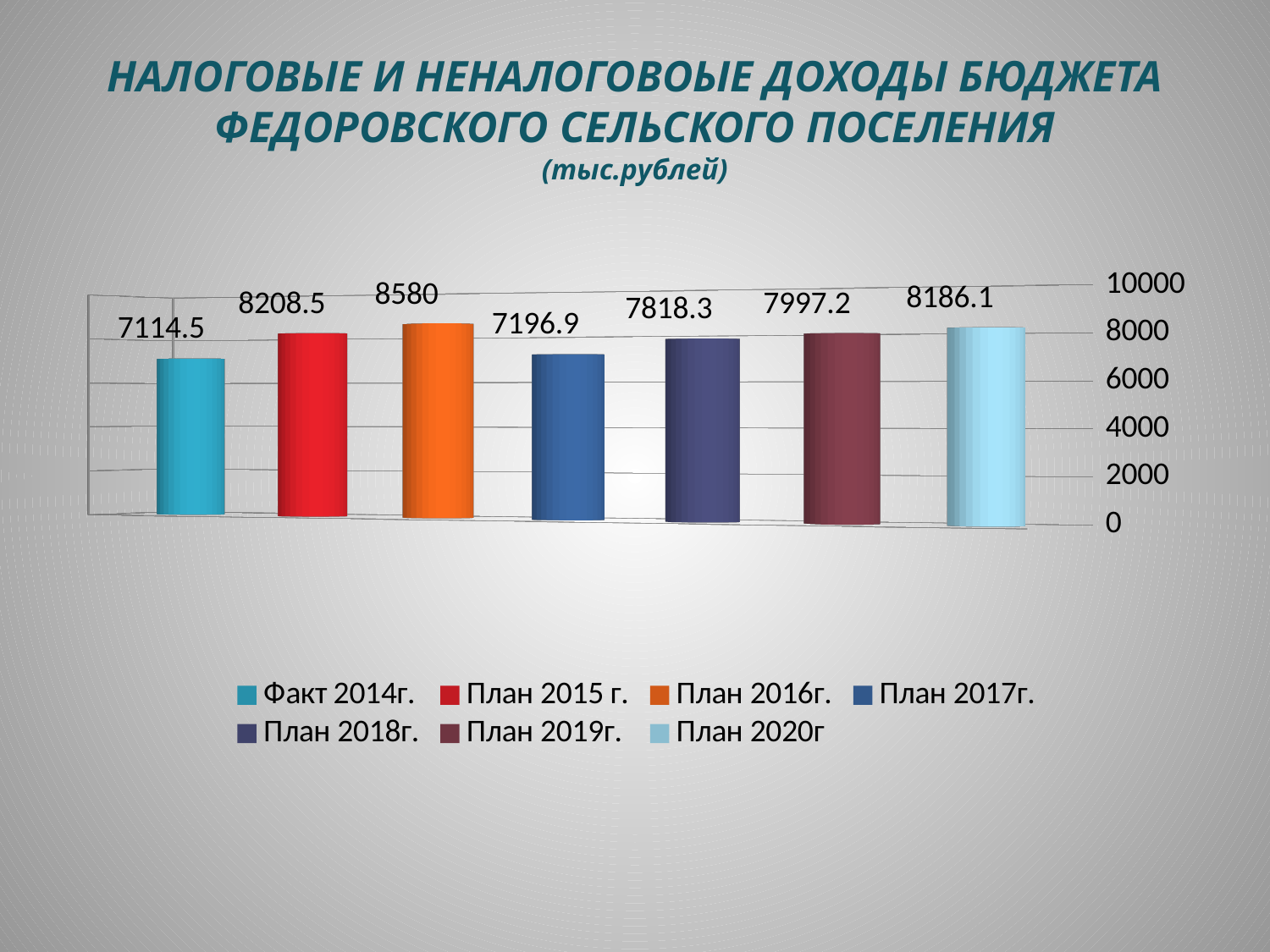
What is the value for План 2020г? 8186.1 Which legend entry has the highest value? План 2016г. What is the value for Факт 2014г.? 7114.5 Which legend entry has the lowest value? Факт 2014г. What is the difference between the values for План 2016г. and Факт 2014г.? 1465.5 What is the difference between the values for План 2019г. and План 2017г.? 800.3 How many bars are plotted in the chart? 7 What is the value for План 2016г.? 8580 What kind of chart is shown on the slide? bar chart What is the value for План 2018г.? 7818.3 How many entries does the legend list? 7 Which is larger, the value for План 2015 г. or the value for План 2020г? План 2015 г.